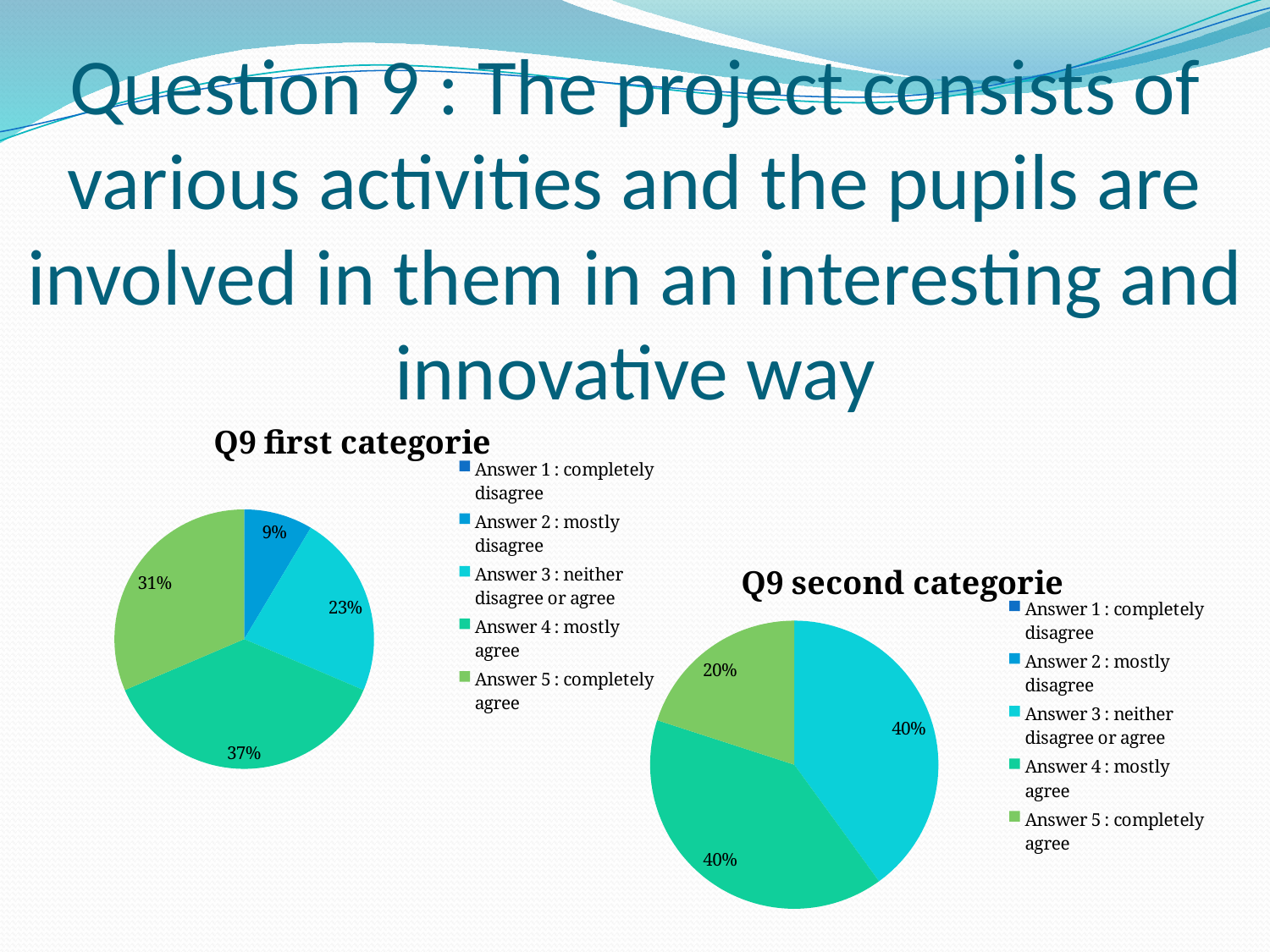
In the 'Q9 first categorie' chart, what percentage is shown for 'Answer 5 : completely agree'? 31% In the 'Q9 first categorie' chart, which answer has the largest slice? Answer 4 : mostly agree In the 'Q9 first categorie' chart, what is the smallest percentage shown on any slice? 9% In the 'Q9 second categorie' chart, what percentage is shown for 'Answer 5 : completely agree'? 20% In the 'Q9 first categorie' chart, what percentage is shown for 'Answer 4 : mostly agree'? 37% In the 'Q9 first categorie' chart, what is the difference in percentage points between 'Answer 4 : mostly agree' and 'Answer 5 : completely agree'? 6 percentage points How many slices with data labels are shown in the 'Q9 second categorie' chart? 3 How many entries does the legend of the 'Q9 second categorie' chart list? 5 In the 'Q9 second categorie' chart, which is larger: the slice for 'Answer 3 : neither disagree or agree' or the slice for 'Answer 5 : completely agree'? Answer 3 : neither disagree or agree In the 'Q9 second categorie' chart, what percentage is shown for 'Answer 3 : neither disagree or agree'? 40% In the 'Q9 first categorie' chart, what percentage is shown for 'Answer 3 : neither disagree or agree'? 23% What kind of chart is the 'Q9 first categorie' chart? pie chart